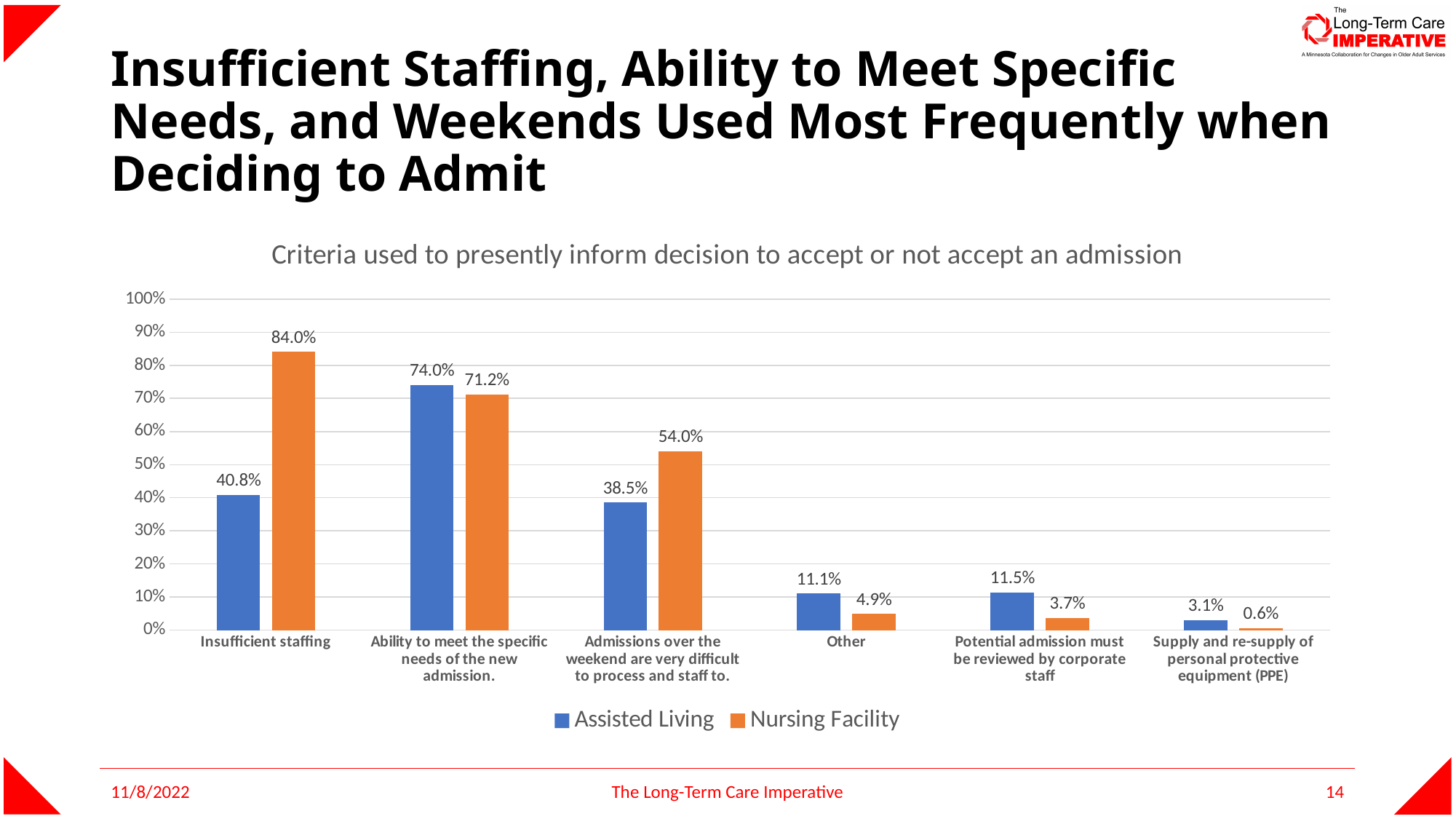
How many categories are shown on the x axis? 6 What is the Assisted Living value for Admissions over the weekend are very difficult to process and staff to.? 38.5% What is the Nursing Facility value for Supply and re-supply of personal protective equipment (PPE)? 0.6% For Other, which series has the larger value, Assisted Living or Nursing Facility? Assisted Living What is the difference between the Nursing Facility and Assisted Living values for Insufficient staffing? 43.2% What is the title of the chart? Criteria used to presently inform decision to accept or not accept an admission Which category has the highest Assisted Living value? Ability to meet the specific needs of the new admission. Is the Nursing Facility value for Admissions over the weekend are very difficult to process and staff to. greater or less than 50%? greater What kind of chart is shown on the slide? bar chart How many series does the legend list? 2 What is the Nursing Facility value for Insufficient staffing? 84.0% Which category has the lowest Nursing Facility value? Supply and re-supply of personal protective equipment (PPE)